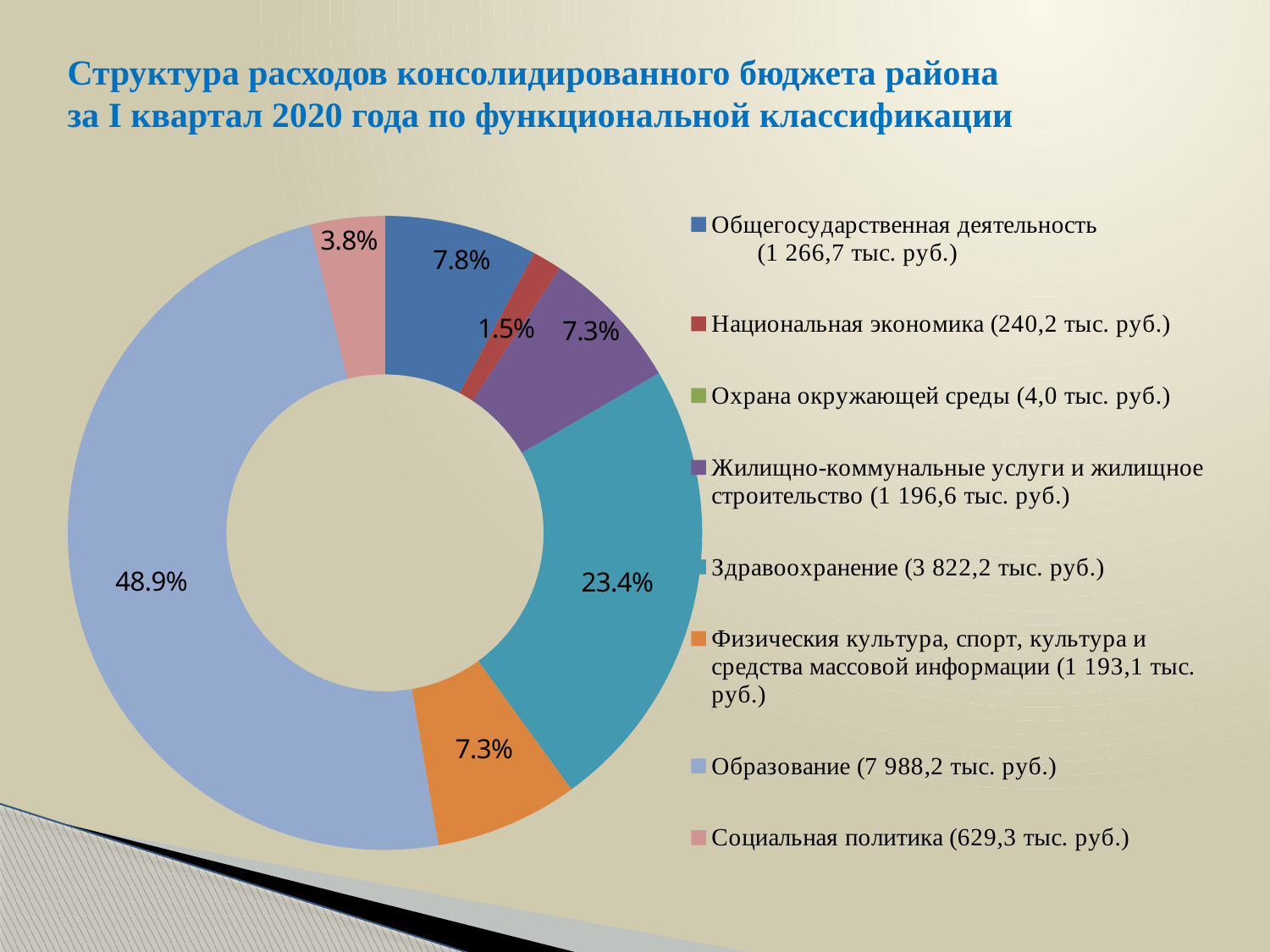
Which is larger: the share of Здравоохранение or the share of Общегосударственная деятельность? Здравоохранение How many categories does the legend list? 8 Which category has the largest share of the budget expenditures? Образование By how many percentage points does the share of Образование exceed that of Здравоохранение? 25.5 percentage points What percentage is shown for Социальная политика? 3.8% What share of expenditures does Образование account for? 48.9% Which labelled slice has the smallest share? Национальная экономика (1.5%) What kind of chart is shown on the slide? Doughnut (pie) chart What share of expenditures does Здравоохранение account for? 23.4% What percentage is shown for Национальная экономика? 1.5% According to the legend, what is the amount for Образование in thousand rubles? 7 988,2 тыс. руб. What percentage is shown for Общегосударственная деятельность? 7.8%